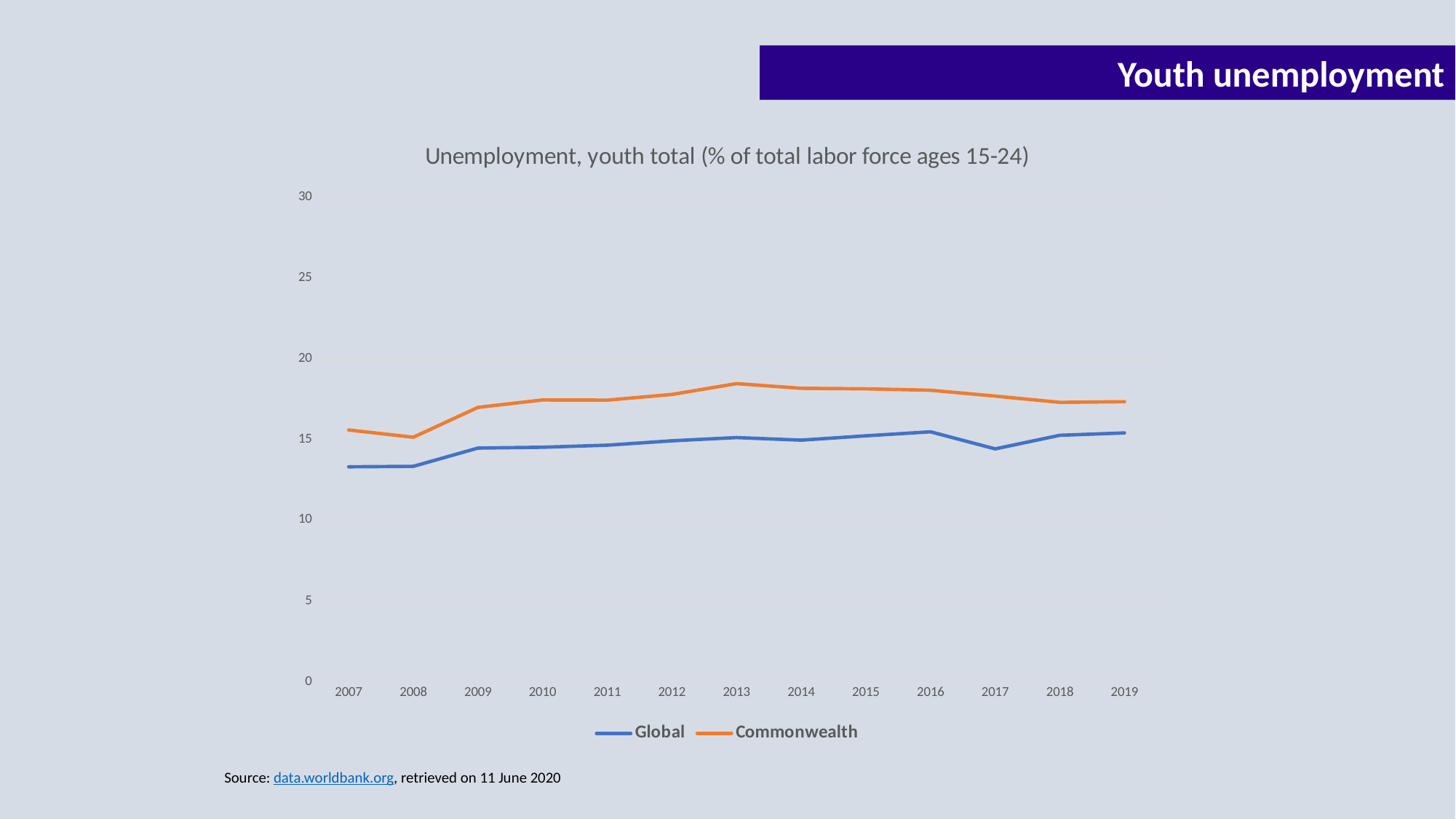
How many series does the legend list? 2 Is the Global value for 2007 greater or less than 15? less Is the Commonwealth value for 2013 greater or less than 20? less In which year does the Commonwealth series reach its highest value? 2013 What is the title of the chart? Unemployment, youth total (% of total labor force ages 15-24) In which year is the Commonwealth series at its lowest value? 2008 Does the Global series rise or fall between 2007 and 2009? rise What kind of chart is shown on the slide? line chart Which series has the higher value in 2013, Global or Commonwealth? Commonwealth Does the Commonwealth series rise or fall between 2013 and 2019? fall How many years are shown on the x axis? 13 Is the Commonwealth value for 2009 greater or less than 15? greater